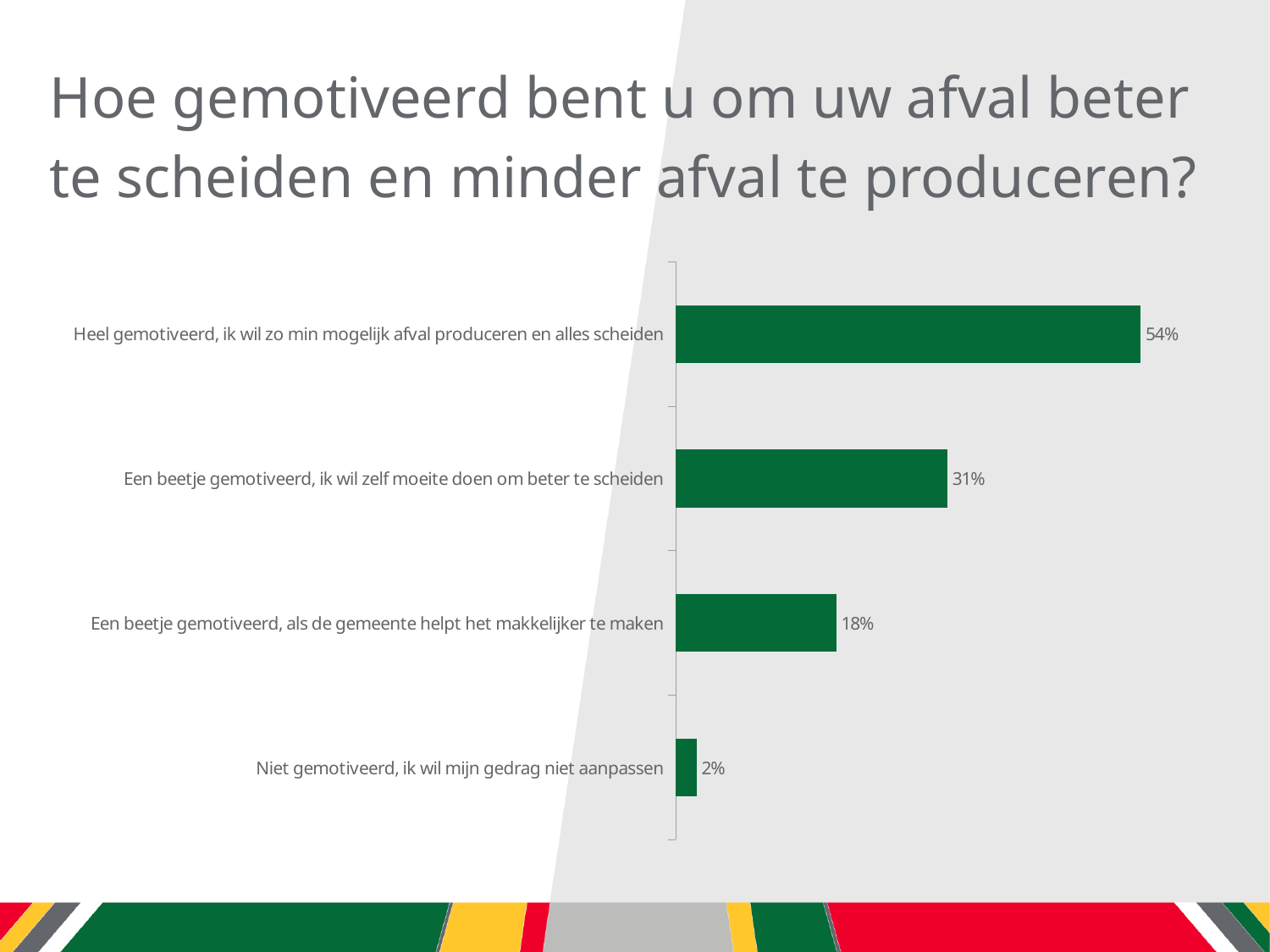
What is the value for "Een beetje gemotiveerd, ik wil zelf moeite doen om beter te scheiden"? 31% What kind of chart is shown on the slide? Bar chart Which category has the lowest value? Niet gemotiveerd, ik wil mijn gedrag niet aanpassen How many categories are shown in the chart? 4 Which is larger: the value for "Een beetje gemotiveerd, als de gemeente helpt het makkelijker te maken" or for "Niet gemotiveerd, ik wil mijn gedrag niet aanpassen"? Een beetje gemotiveerd, als de gemeente helpt het makkelijker te maken What is the difference between the two "Een beetje gemotiveerd" categories? 13% What colour are the bars in the chart? Green What is the difference between the "Heel gemotiveerd" value and the "Een beetje gemotiveerd, ik wil zelf moeite doen om beter te scheiden" value? 23% What percentage chose "Niet gemotiveerd, ik wil mijn gedrag niet aanpassen"? 2% What percentage of respondents chose "Heel gemotiveerd, ik wil zo min mogelijk afval produceren en alles scheiden"? 54% What is the value for "Een beetje gemotiveerd, als de gemeente helpt het makkelijker te maken"? 18% Which category has the highest value? Heel gemotiveerd, ik wil zo min mogelijk afval produceren en alles scheiden